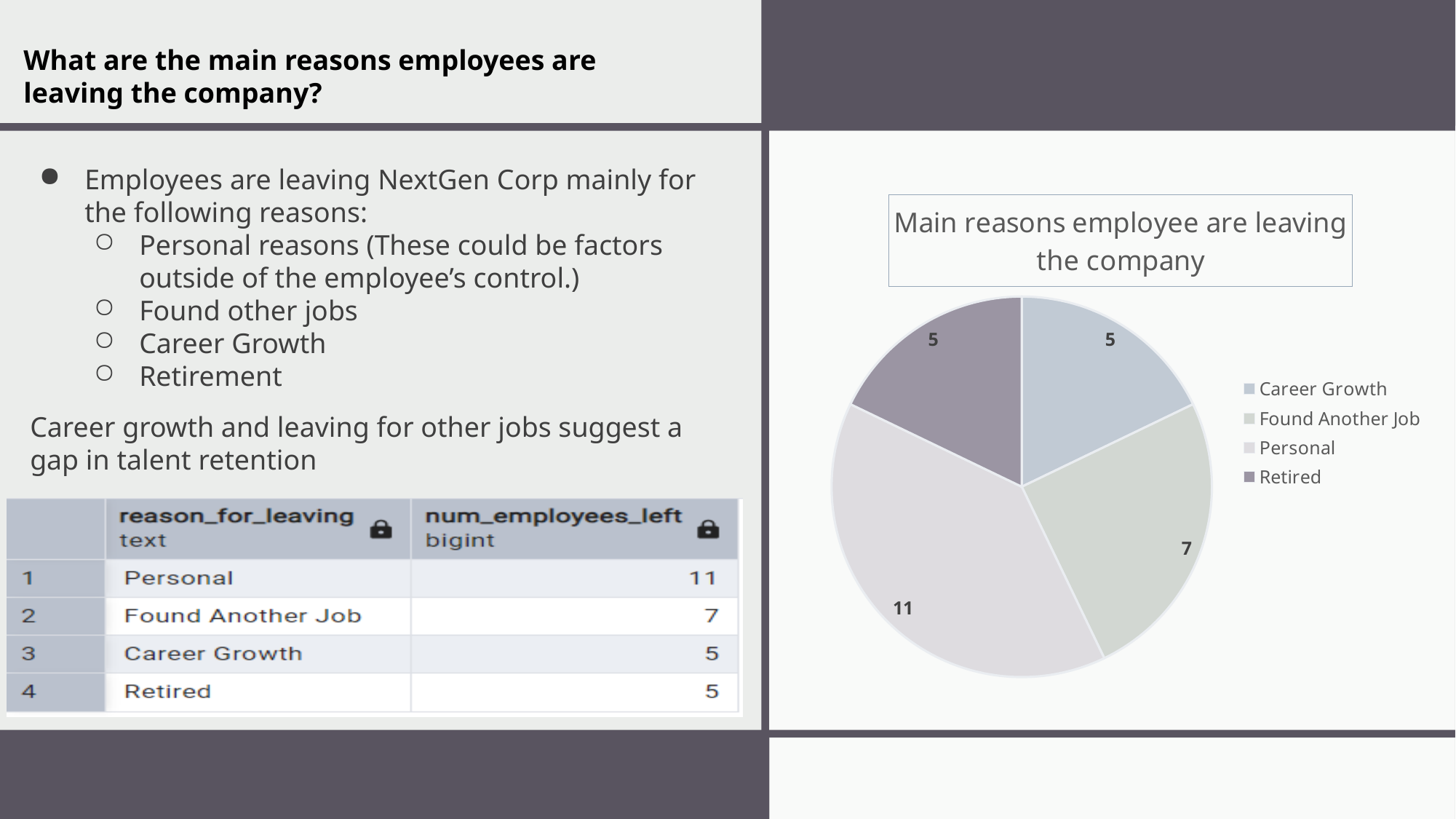
What is the title of the chart? Main reasons employee are leaving the company What is the value for Personal in the pie chart? 11 What is the total of all slices in the pie chart? 28 What is the value for Career Growth in the pie chart? 5 What is the value for Found Another Job in the pie chart? 7 Which category has the largest slice in the pie chart? Personal What is the difference between the values for Personal and Found Another Job? 4 How many slices does the pie chart have? 4 What kind of chart is shown on the slide? pie chart Which legend entry is listed last in the pie chart's legend? Retired What is the value for Retired in the pie chart? 5 Which is larger, the value for Found Another Job or the value for Career Growth? Found Another Job